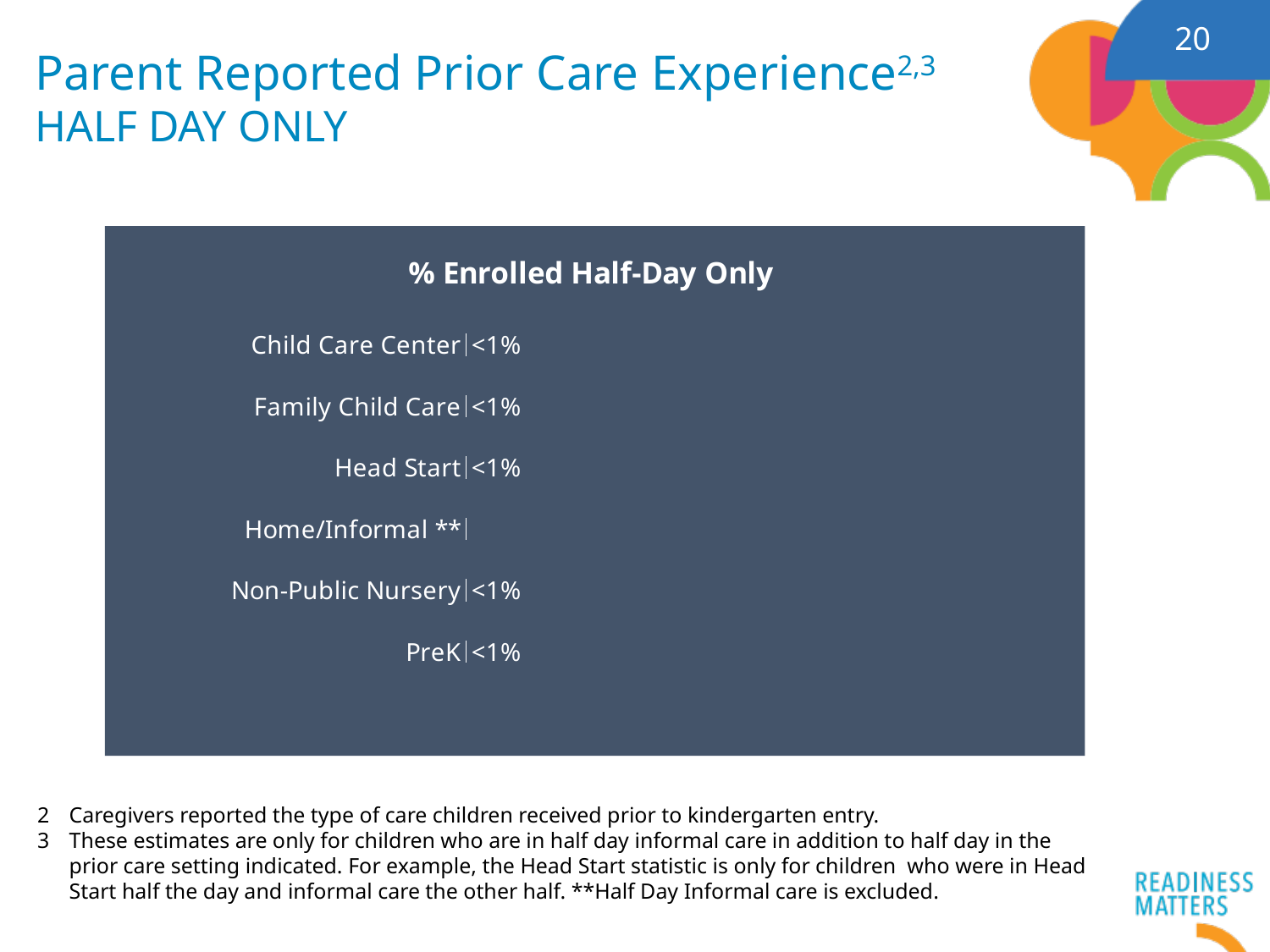
How many categories are listed in the % Enrolled Half-Day Only chart? 6 What is the value shown for Head Start in the % Enrolled Half-Day Only chart? <1% What is the value shown for PreK in the % Enrolled Half-Day Only chart? <1% What is the value shown for Family Child Care in the % Enrolled Half-Day Only chart? <1% Which category in the % Enrolled Half-Day Only chart has no percentage value shown, only asterisks? Home/Informal What is the title of the chart on the slide? % Enrolled Half-Day Only Is the value for Head Start in the % Enrolled Half-Day Only chart greater or less than 1%? less What is the value shown for Non-Public Nursery in the % Enrolled Half-Day Only chart? <1% Is the value for PreK in the % Enrolled Half-Day Only chart greater or less than 1%? less What is the value shown for Child Care Center in the % Enrolled Half-Day Only chart? <1%